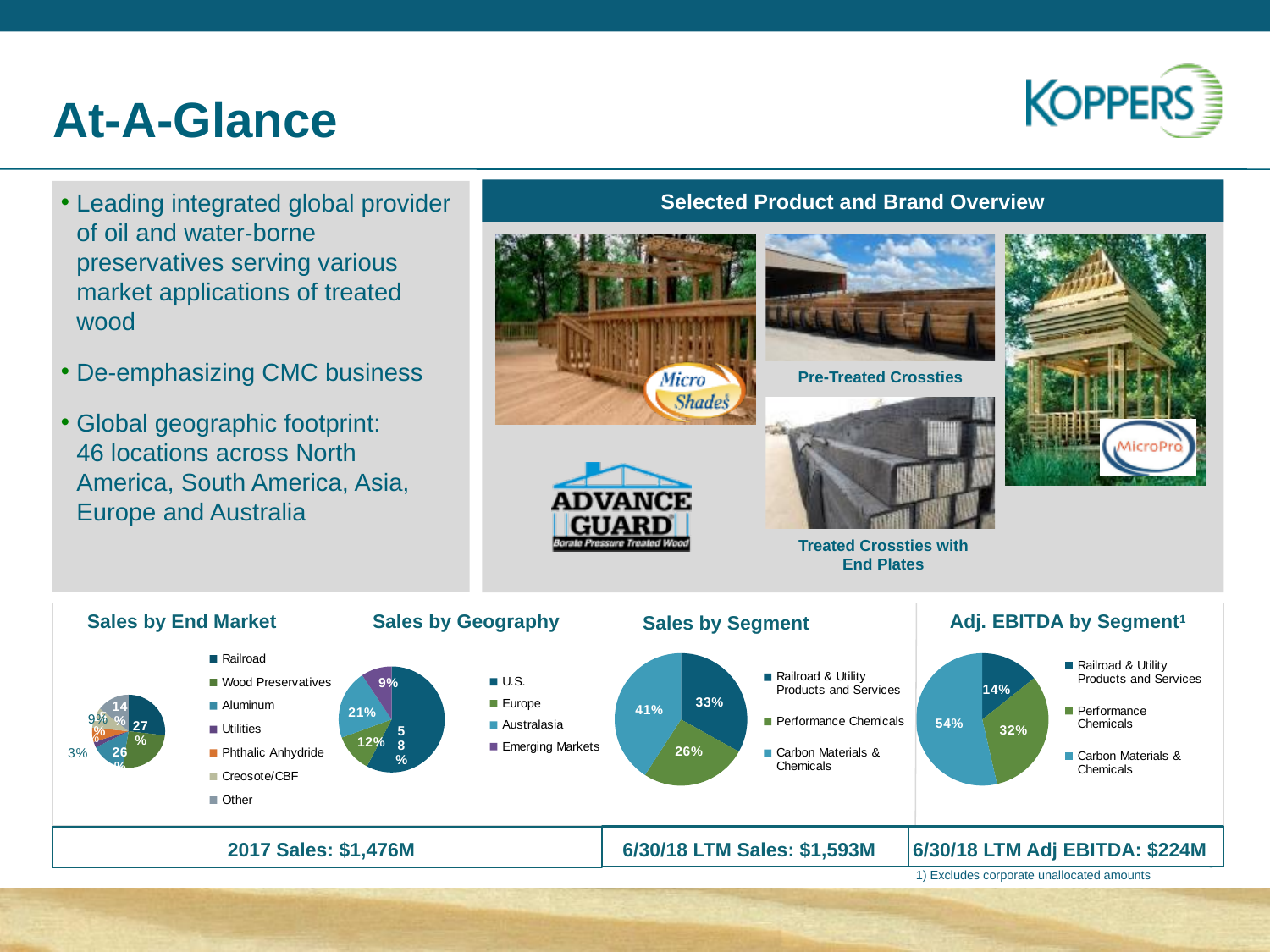
What type of chart is the Sales by Segment chart? pie chart How many slices does the Sales by Geography pie chart have? 4 In the Sales by Geography chart, what share of sales comes from Europe? 12% In the Sales by Segment chart, which segment has the largest share of sales? Carbon Materials & Chemicals In the Adj. EBITDA by Segment chart, is the share for Performance Chemicals larger or smaller than the share for Carbon Materials & Chemicals? smaller In the Sales by Geography chart, what share of sales comes from the U.S.? 58% How many entries does the legend of the Sales by End Market chart list? 7 In the Adj. EBITDA by Segment chart, what share is attributed to Railroad & Utility Products and Services? 14% In the Sales by Geography chart, which region has the smallest share of sales? Emerging Markets In the Adj. EBITDA by Segment chart, which segment has the smallest share? Railroad & Utility Products and Services In the Sales by Geography chart, what is the difference between the Europe share and the Australasia share? 9% In the Sales by Segment chart, what share of sales comes from Performance Chemicals? 26%